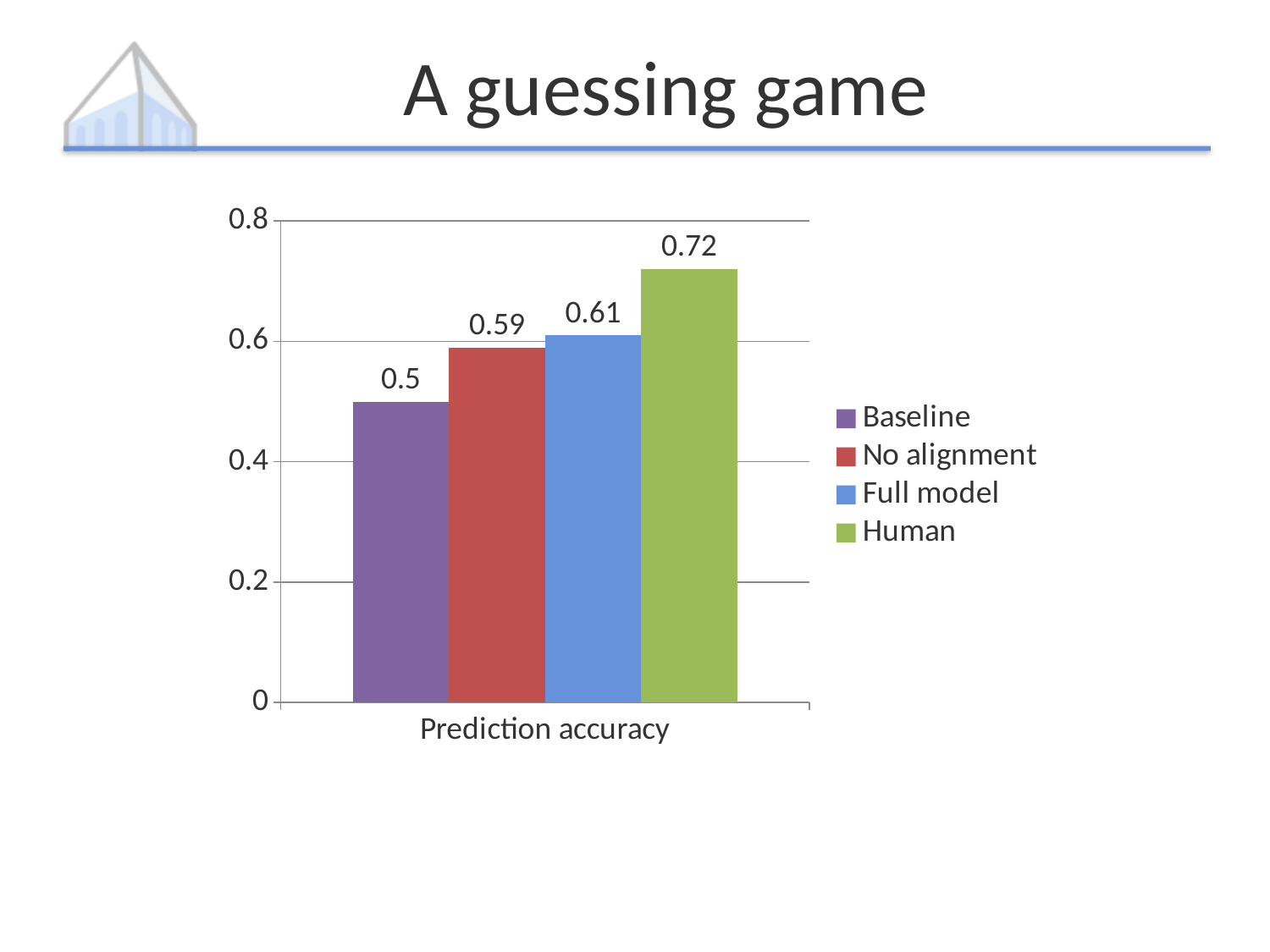
What is the prediction accuracy for No alignment? 0.59 What is the prediction accuracy for Baseline? 0.5 What is the prediction accuracy for Full model? 0.61 What is the label on the x axis of the chart? Prediction accuracy Which series has the highest prediction accuracy? Human How many series does the legend list? 4 Which has a higher prediction accuracy, No alignment or Human? Human Which series has the lowest prediction accuracy? Baseline What is the prediction accuracy for Human? 0.72 What is the difference in prediction accuracy between Human and Full model? 0.11 What kind of chart is shown on the slide? Bar chart What is the difference in prediction accuracy between Full model and Baseline? 0.11